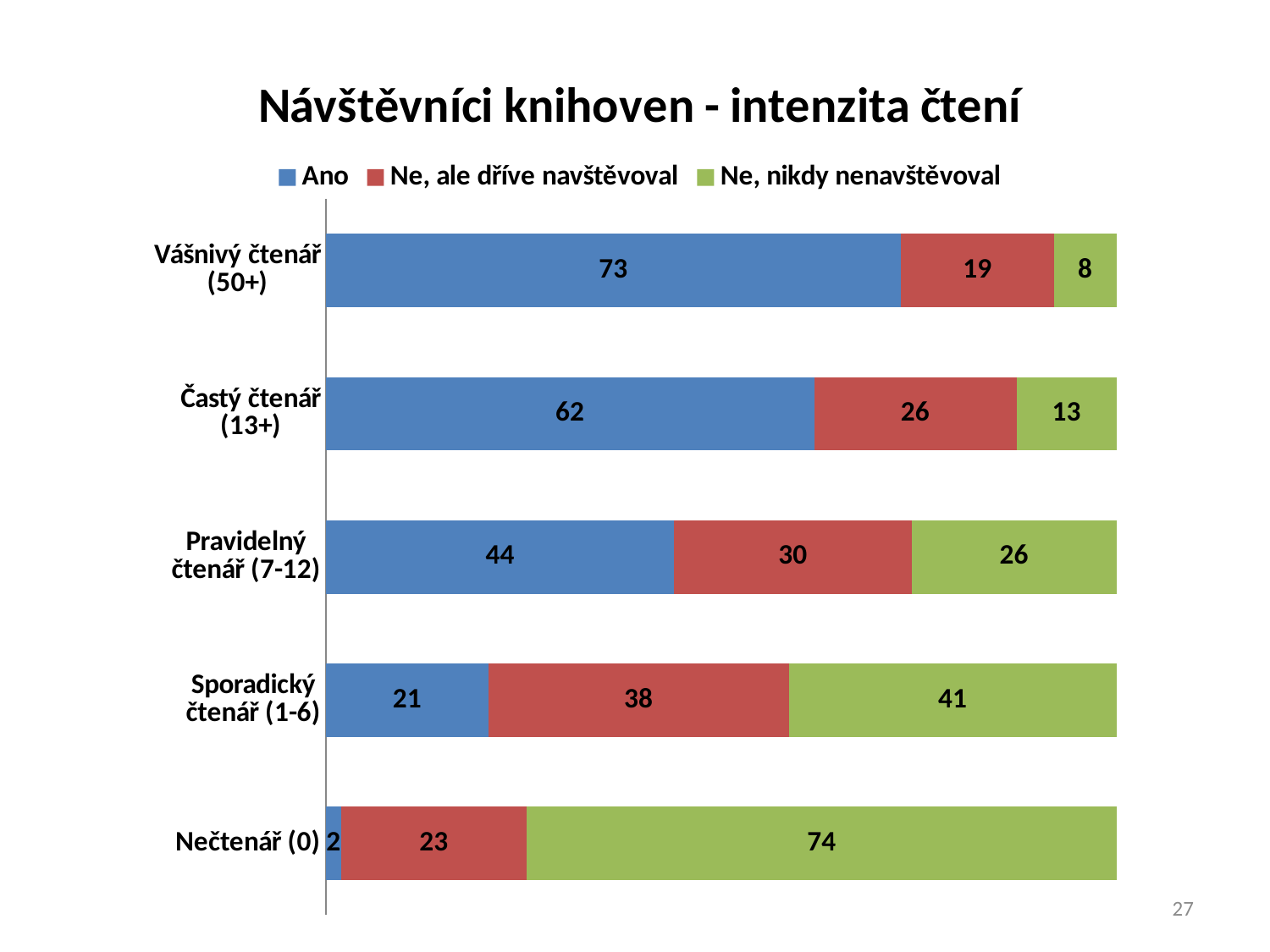
Which is larger: "Ne, ale dříve navštěvoval" for Pravidelný čtenář (7-12) or for Nečtenář (0)? Pravidelný čtenář (7-12) What kind of chart is shown? Stacked bar chart What is the title of the chart? Návštěvníci knihoven - intenzita čtení What is the difference between the "Ano" values for Častý čtenář (13+) and Pravidelný čtenář (7-12)? 18 Which category has the lowest value for "Ne, nikdy nenavštěvoval"? Vášnivý čtenář (50+) How many categories are shown on the chart? 5 What is the value of "Ne, nikdy nenavštěvoval" for Nečtenář (0)? 74 How many series does the legend list? 3 Which category has the highest value for "Ano"? Vášnivý čtenář (50+) What is the value of "Ano" for Vášnivý čtenář (50+)? 73 What is the value of "Ne, ale dříve navštěvoval" for Sporadický čtenář (1-6)? 38 What is the total of the stacked bar for Pravidelný čtenář (7-12)? 100